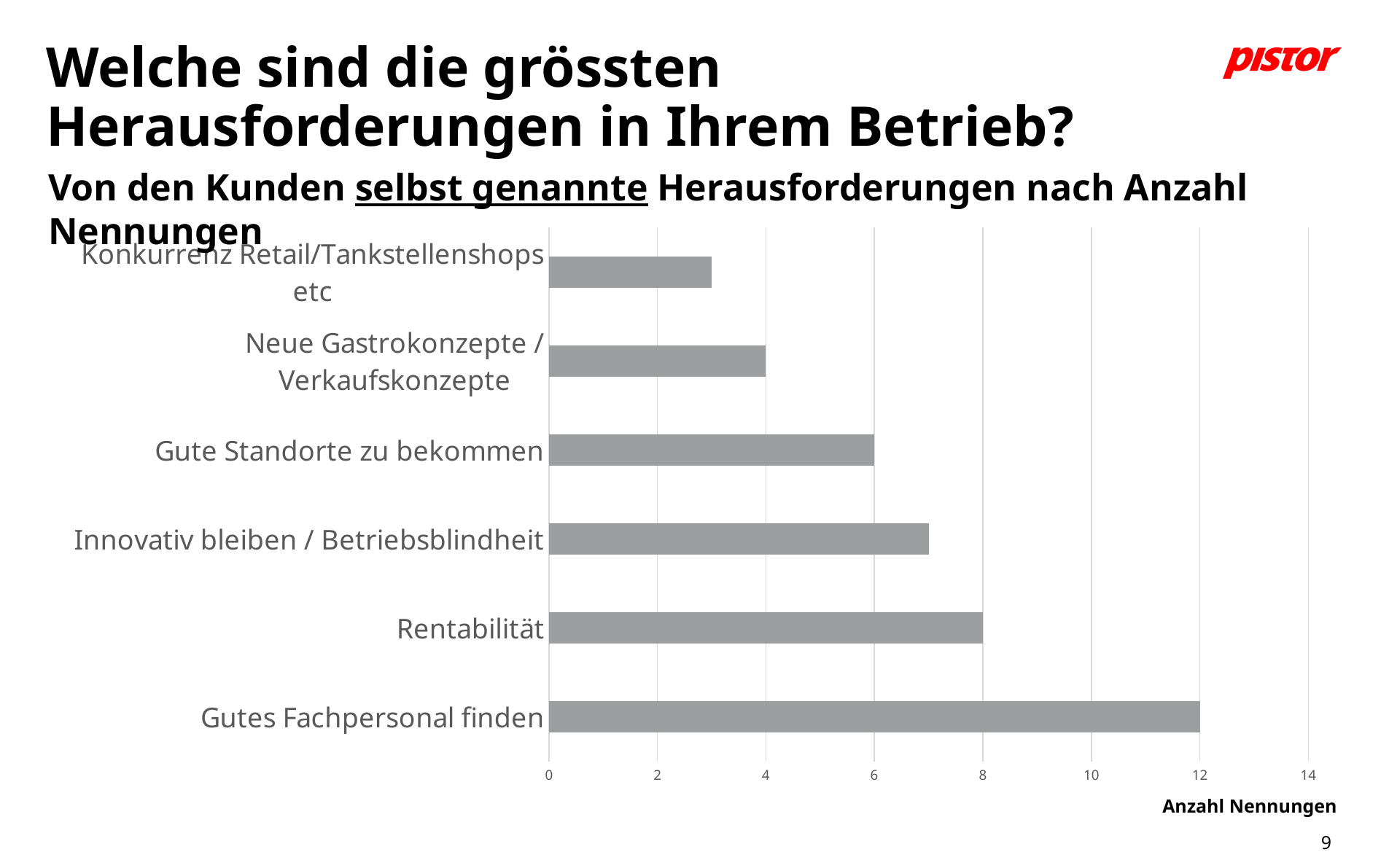
How many mentions does 'Gutes Fachpersonal finden' have? 12 What kind of chart is shown on the slide? bar chart What is the label of the horizontal axis? Anzahl Nennungen How many mentions does 'Rentabilität' have? 8 What is the difference in mentions between 'Gutes Fachpersonal finden' and 'Rentabilität'? 4 Is the value for 'Innovativ bleiben / Betriebsblindheit' greater or less than 6? greater How many categories (challenges) are shown in the chart? 6 Is the value for 'Konkurrenz Retail/Tankstellenshops etc' greater or less than 4? less Which challenge has the lowest number of mentions? Konkurrenz Retail/Tankstellenshops etc How many mentions does 'Neue Gastrokonzepte / Verkaufskonzepte' have? 4 How many mentions does 'Gute Standorte zu bekommen' have? 6 Which challenge has the highest number of mentions? Gutes Fachpersonal finden